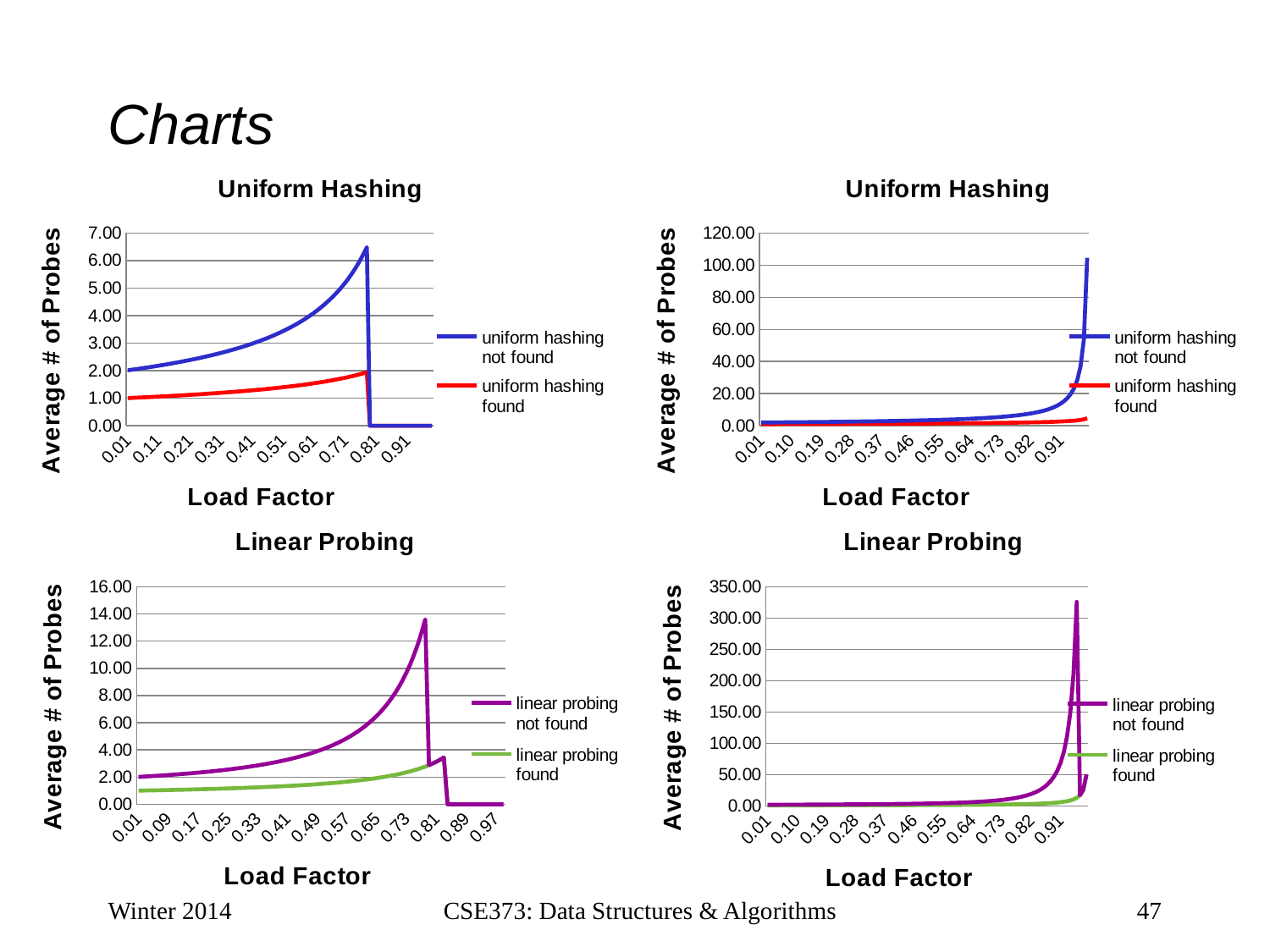
What type of chart is the top-left 'Uniform Hashing' chart? line chart What are the two legend entries of the bottom-right 'Linear Probing' chart? linear probing not found; linear probing found In the top-right 'Uniform Hashing' chart, is the peak value of 'uniform hashing not found' greater or less than 80.00? greater In the bottom-left 'Linear Probing' chart, at load factor 0.65, which series has the higher value? linear probing not found How many series does the legend of the bottom-left 'Linear Probing' chart list? 2 In the top-right 'Uniform Hashing' chart, does the 'uniform hashing not found' series rise or fall as the load factor increases from 0.01 to 0.91? rise In the bottom-right 'Linear Probing' chart, is the peak value of 'linear probing not found' greater or less than 300.00? greater How many series does the legend of the top-left 'Uniform Hashing' chart list? 2 What is the y-axis title of the bottom-left 'Linear Probing' chart? Average # of Probes In the top-left 'Uniform Hashing' chart, at load factor 0.51, which series has the higher value? uniform hashing not found In the bottom-left 'Linear Probing' chart, is the peak value of 'linear probing not found' greater or less than 12.00? greater